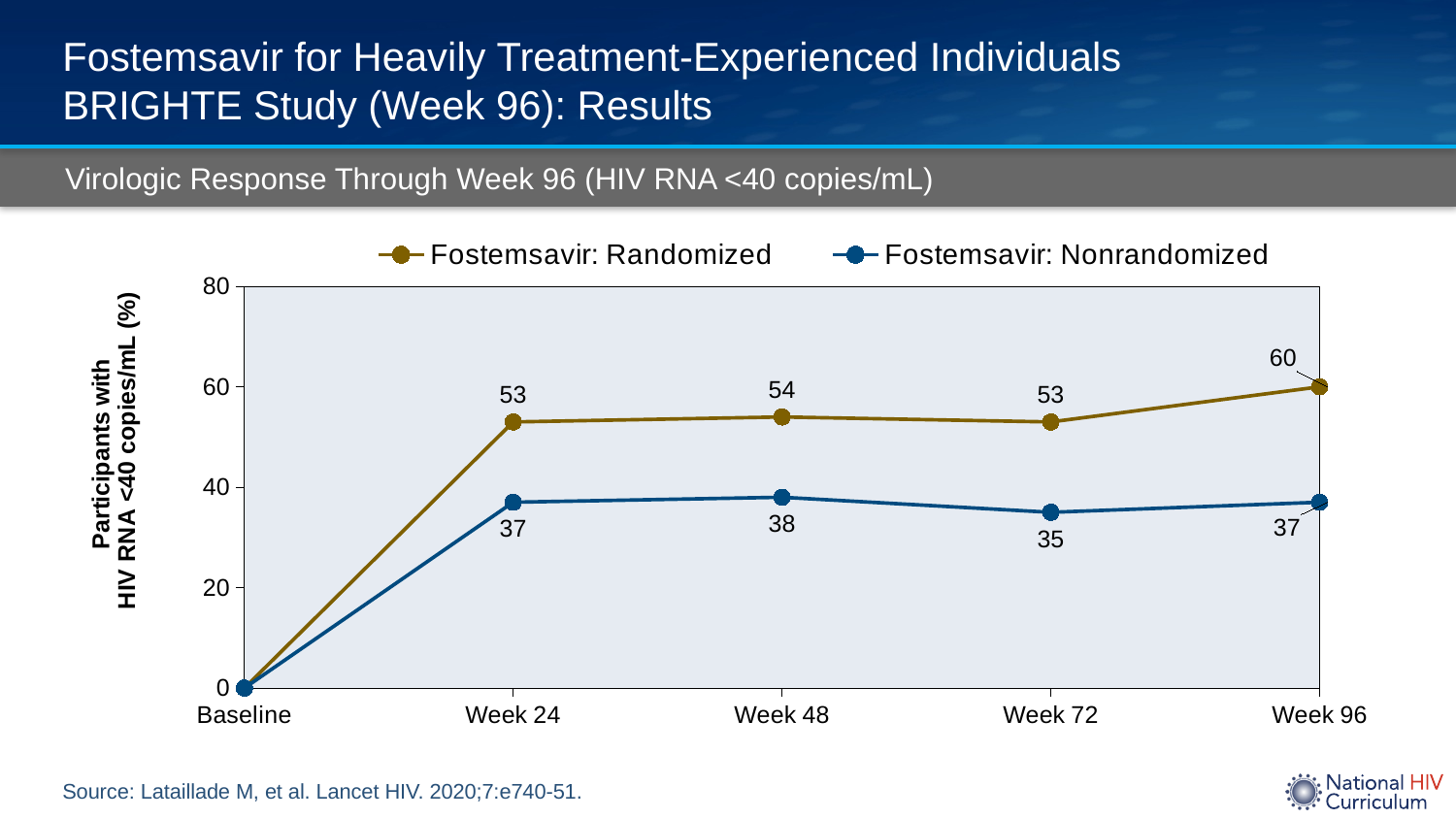
How many time points are plotted on the x axis? 5 What is the difference between the Fostemsavir: Randomized and Fostemsavir: Nonrandomized values at Week 96? 23 At which time point after Baseline is the Fostemsavir: Nonrandomized series lowest? Week 72 What is the title of the chart? Virologic Response Through Week 96 (HIV RNA <40 copies/mL) What kind of chart is shown on the slide? Line chart What is the value for Fostemsavir: Randomized at Week 48? 54 At which time point is the Fostemsavir: Randomized series highest? Week 96 Is the value for Fostemsavir: Nonrandomized at Week 48 greater or less than 40? less What is the value for Fostemsavir: Nonrandomized at Week 72? 35 What is the value for Fostemsavir: Randomized at Week 96? 60 How many series does the legend list? 2 Which series has the larger value at Week 24, Fostemsavir: Randomized or Fostemsavir: Nonrandomized? Fostemsavir: Randomized